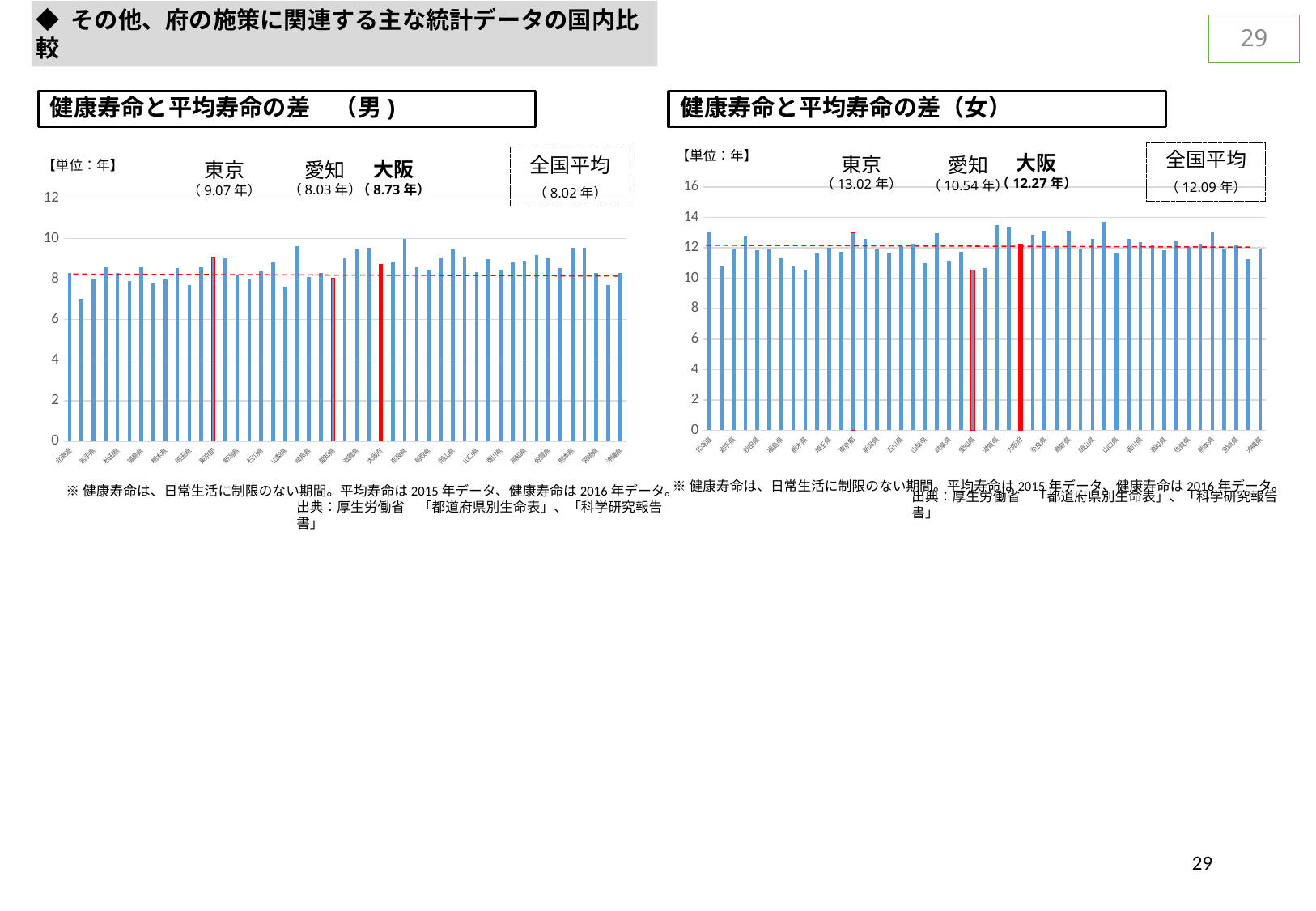
In the 健康寿命と平均寿命の差（男） chart, which is larger, the value for 大阪 or the value for 愛知? 大阪 What kind of chart is used on the slide for 健康寿命と平均寿命の差（男）? bar chart In the 健康寿命と平均寿命の差（女） chart, what is the difference between the values for 大阪 and 愛知? 1.73年 In the 健康寿命と平均寿命の差（男） chart, what is the value for 大阪? 8.73年 In the 健康寿命と平均寿命の差（女） chart, is the value for 大阪 greater or less than the 全国平均? greater In the 健康寿命と平均寿命の差（女） chart, what is the value for 愛知? 10.54年 In the 健康寿命と平均寿命の差（女） chart, what is the 全国平均 value? 12.09年 In the 健康寿命と平均寿命の差（女） chart, what colour is the bar for 大阪府? red In the 健康寿命と平均寿命の差（男） chart, what is the value for 東京? 9.07年 In the 健康寿命と平均寿命の差（女） chart, what is the value for 東京? 13.02年 In the 健康寿命と平均寿命の差（男） chart, what is the difference between the values for 東京 and 大阪? 0.34年 In the 健康寿命と平均寿命の差（男） chart, what is the 全国平均 value? 8.02年